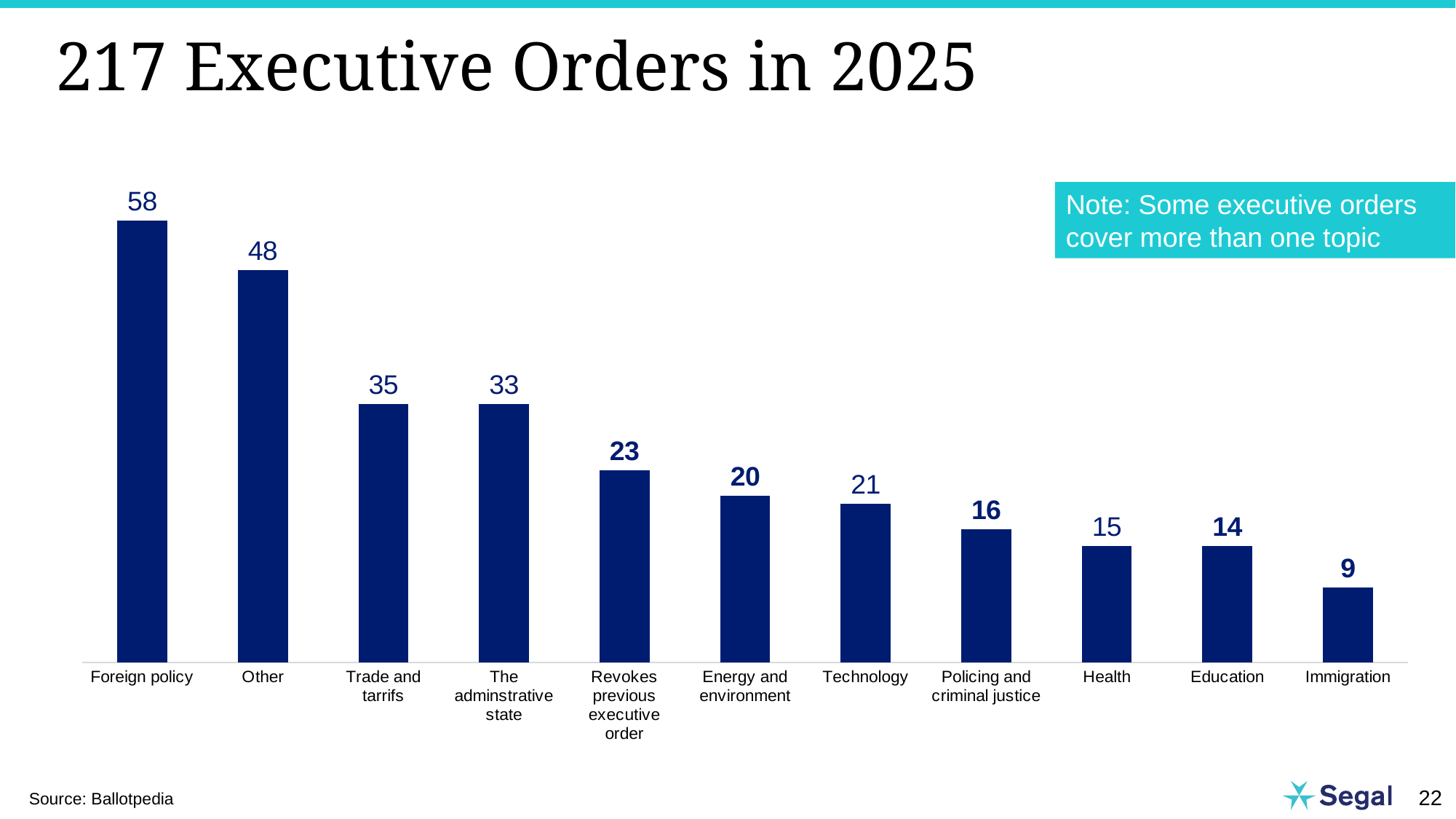
How many executive orders are shown for Foreign policy? 58 What is the value for Trade and tarrifs? 35 What is the source cited for the chart? Ballotpedia What is the value for Revokes previous executive order? 23 What is the value for Health? 15 How many categories are shown on the chart? 11 What is the difference between the values for Education and Immigration? 5 Which category has the highest value? Foreign policy Which category has the lowest value? Immigration What is the difference between the values for Foreign policy and Other? 10 What kind of chart is shown on the slide? Bar chart